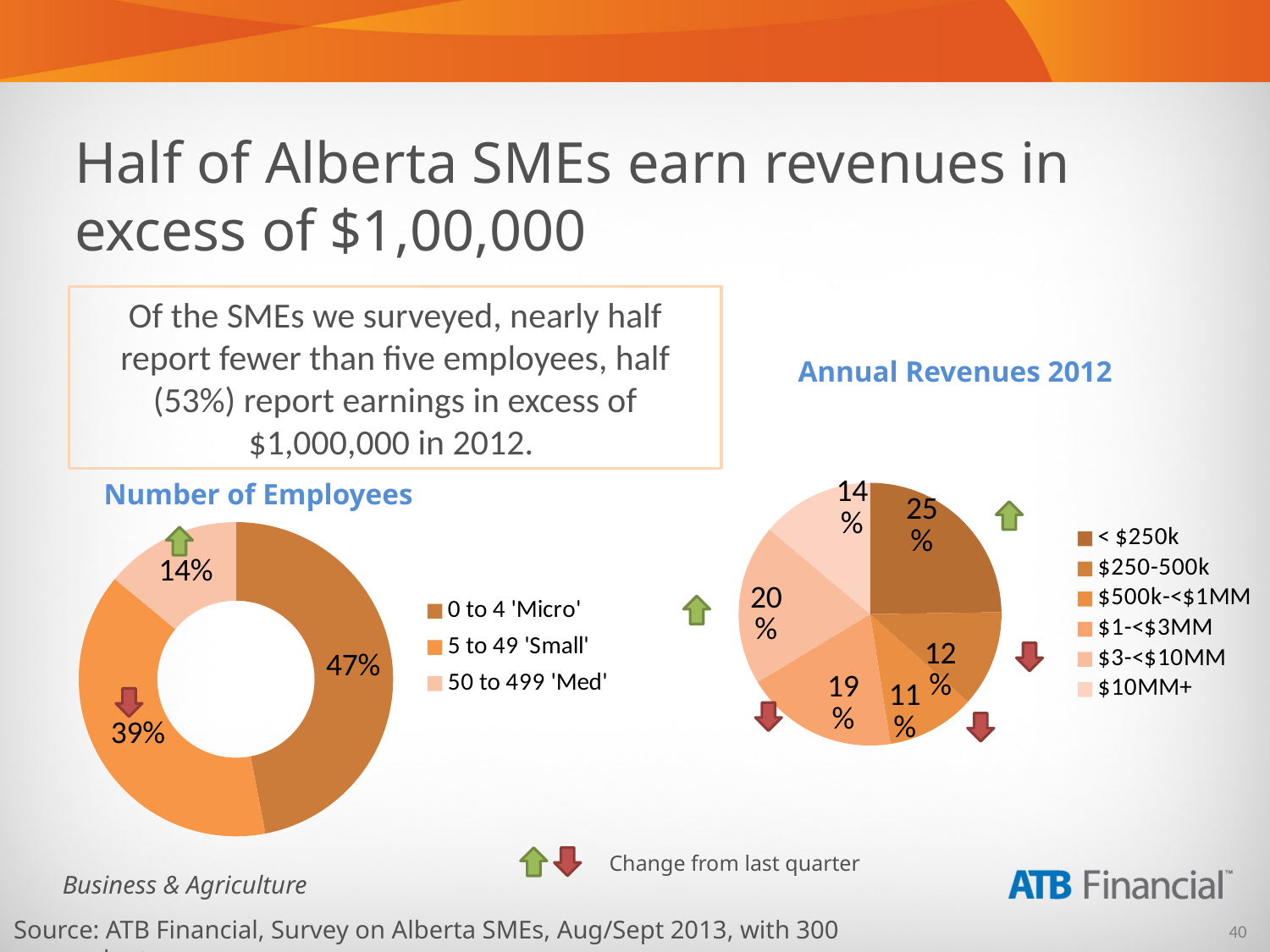
In the Number of Employees chart, what share of SMEs have 50 to 499 'Med' employees? 14% In the Annual Revenues 2012 chart, what is the difference between the < $250k share and the $10MM+ share? 11% In the Annual Revenues 2012 chart, what share of SMEs earn less than $250k? 25% In the Annual Revenues 2012 chart, which is larger: the share for $1-<$3MM or the share for $250-500k? $1-<$3MM In the Number of Employees chart, what share of SMEs have 0 to 4 'Micro' employees? 47% In the Annual Revenues 2012 chart, which revenue category has the smallest share? $500k-<$1MM In the Number of Employees chart, what is the difference between the 0 to 4 'Micro' share and the 5 to 49 'Small' share? 8% How many revenue categories does the legend of the Annual Revenues 2012 chart list? 6 In the Number of Employees chart, which employee-size category has the largest share? 0 to 4 'Micro' What kind of chart is the Number of Employees chart? Donut chart How many categories does the legend of the Number of Employees chart list? 3 In the Annual Revenues 2012 chart, what share of SMEs earn $3-<$10MM? 20%